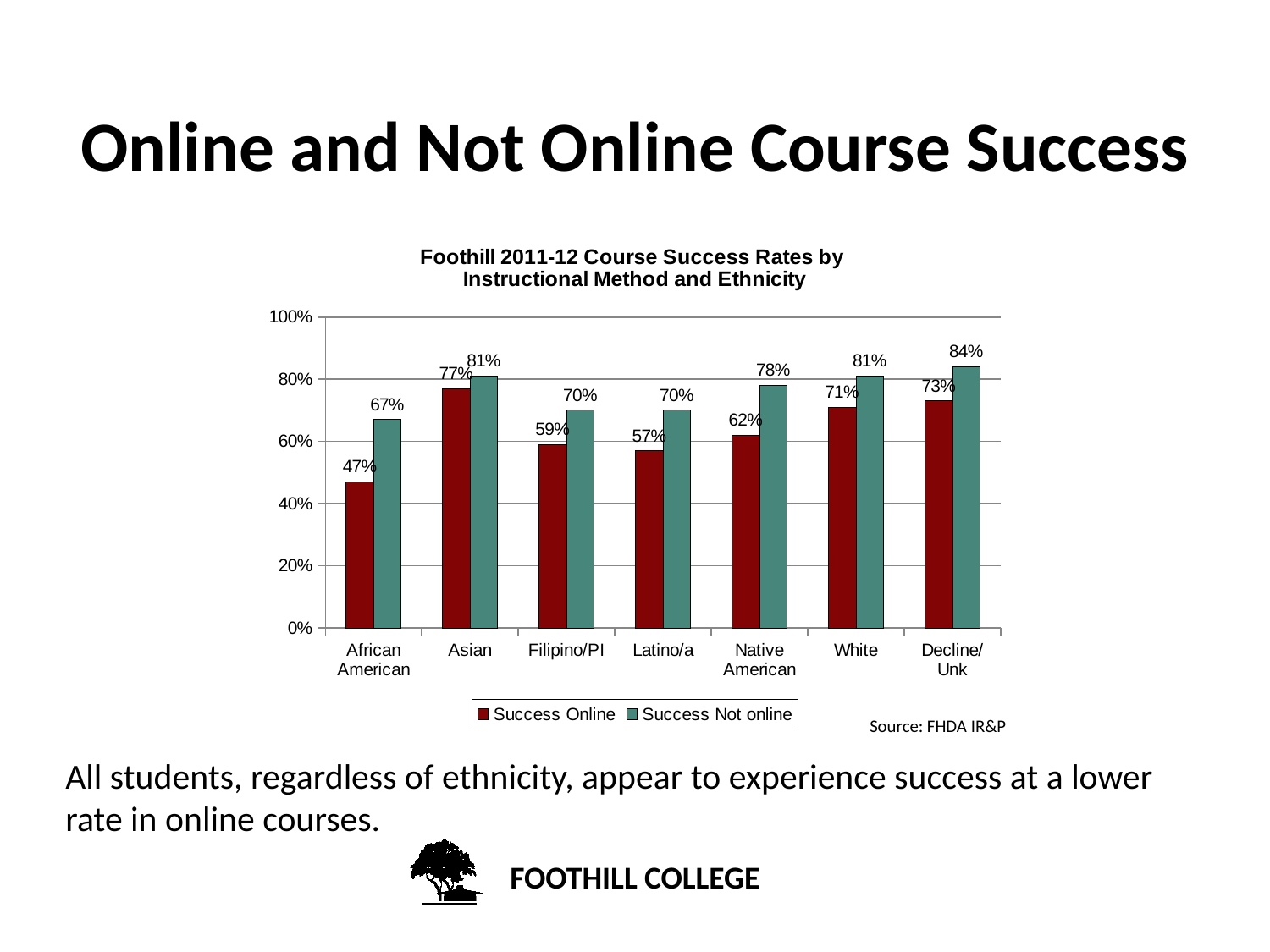
What is the Success Online rate for Latino/a students? 57% Which ethnicity has the lowest Success Not online rate? African American What is the Success Not online rate for Decline/Unk? 84% How many ethnicity categories are shown on the x axis? 7 Which is larger for White students: Success Online or Success Not online? Success Not online What is the difference between the Success Not online and Success Online rates for Native American students? 16% Which ethnicity has the highest Success Online rate? Asian What is the difference between the Success Not online and Success Online rates for African American students? 20% What is the Success Online rate for African American students? 47% What kind of chart is shown on the slide? Bar chart How many series does the legend list? 2 What is the title of the chart? Foothill 2011-12 Course Success Rates by Instructional Method and Ethnicity